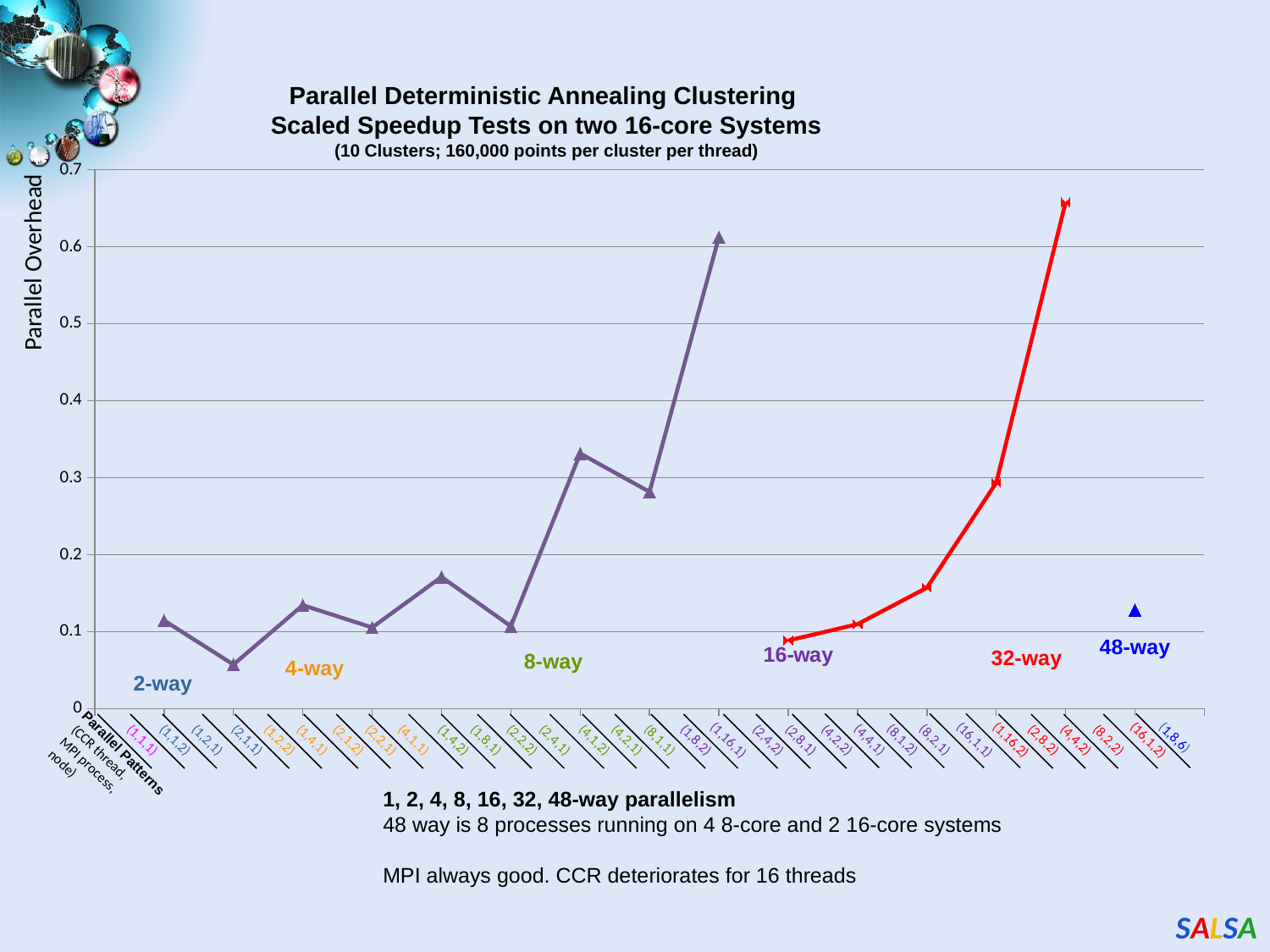
Does the red line rise or fall as it moves from the 16-way region to the 32-way region? rises What is the highest tick value shown on the vertical axis? 0.7 Which line reaches the highest parallel overhead on the chart, the purple line or the red line? the red line What is the title of the chart? Parallel Deterministic Annealing Clustering Scaled Speedup Tests on two 16-core Systems Is the highest point of the purple line greater or less than 0.5? greater Is the value of the blue 48-way point greater or less than 0.1? greater Is the highest point of the purple line greater or less than the highest point of the red line? less Is the first point of the purple line (in the 2-way region) greater or less than 0.2? less What is the label of the vertical axis? Parallel Overhead What kind of chart is shown on the slide? line chart